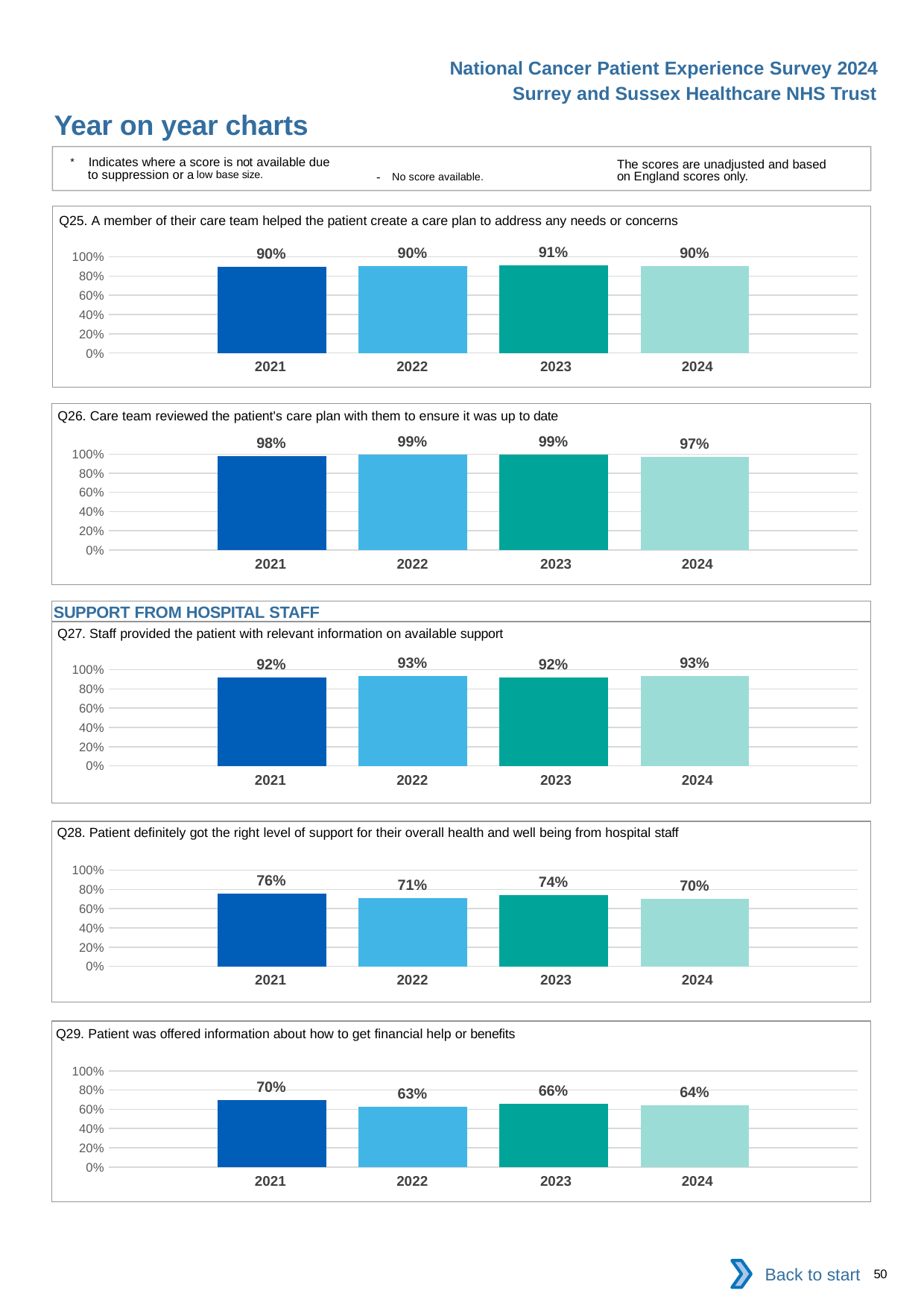
What kind of chart is the Q25 chart? bar chart In the Q28 chart, what is the difference between the 2022 and 2023 values? 3% In the Q29 chart, which is larger, the value for 2022 or the value for 2023? 2023 In the Q28 chart, which year has the highest value? 2021 How many years are shown on the x axis of the Q28 chart? 4 In the Q26 chart, which year has the lowest value? 2024 In the Q28 chart, what is the difference between the 2021 and 2024 values? 6% In the Q27 chart, what is the value for 2024? 93% In the Q25 chart, what is the value for 2023? 91% In the Q29 chart, what is the value for 2021? 70% In the Q26 chart, what is the value for 2021? 98% In the Q29 chart, is the value for 2022 greater or less than 80%? less